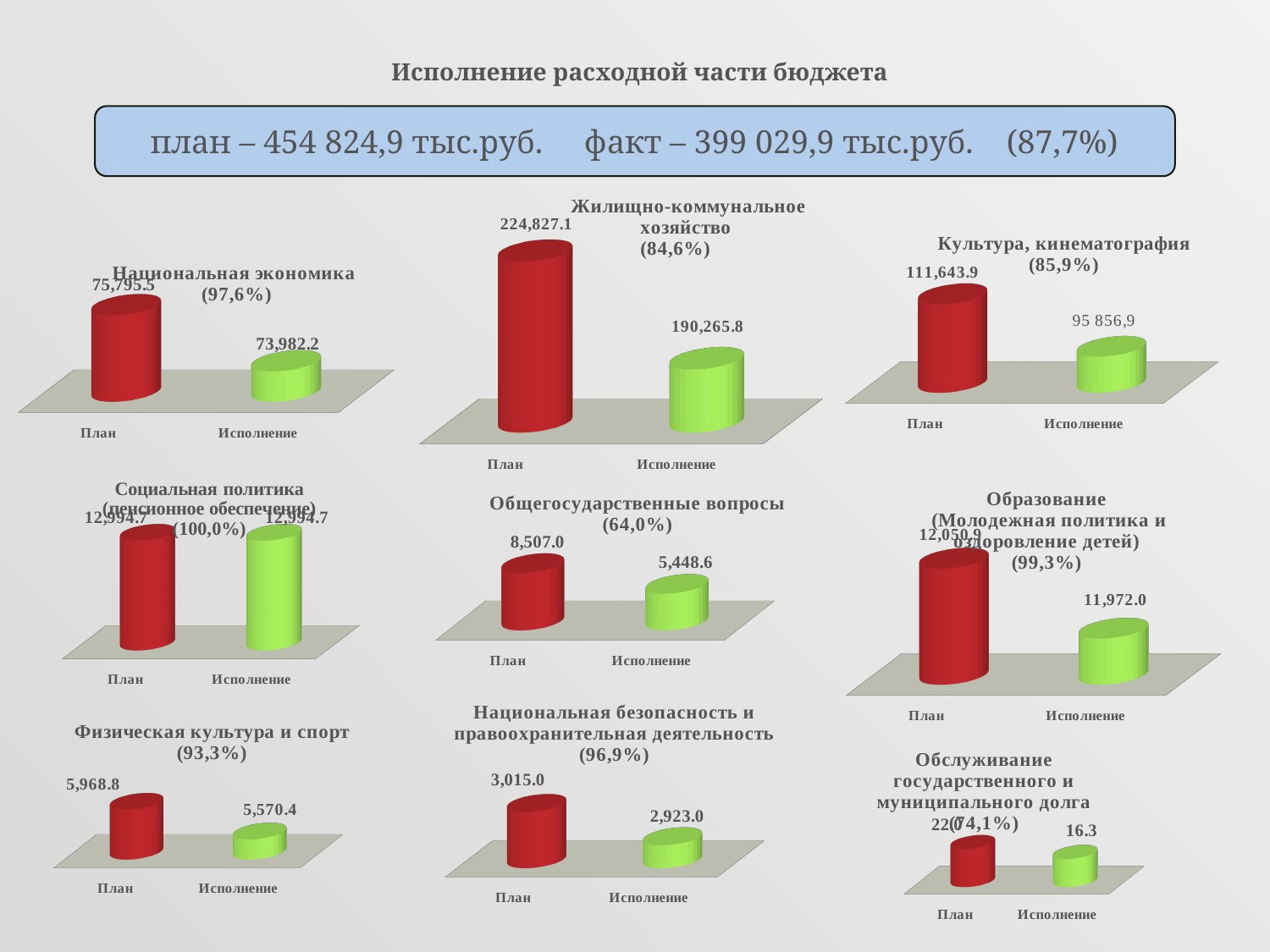
In the Физическая культура и спорт chart, which is larger, План or Исполнение? План In the Национальная экономика chart, what is the value for Исполнение? 73,982.2 In the Национальная безопасность и правоохранительная деятельность chart, what is the value for Исполнение? 2,923.0 In the Жилищно-коммунальное хозяйство chart, what is the value for Исполнение? 190,265.8 In the Жилищно-коммунальное хозяйство chart, what is the difference between План and Исполнение? 34,561.3 What kind of chart is the Общегосударственные вопросы chart? bar chart How many categories does the Образование chart show? 2 In the Культура, кинематография chart, what is the value for План? 111,643.9 In the Общегосударственные вопросы chart, what is the difference between План and Исполнение? 3,058.4 What percentage is shown in the title of the Общегосударственные вопросы chart? 64,0% In the Социальная политика (пенсионное обеспечение) chart, what is the value for Исполнение? 12,994.7 In the Жилищно-коммунальное хозяйство chart, what is the value for План? 224,827.1